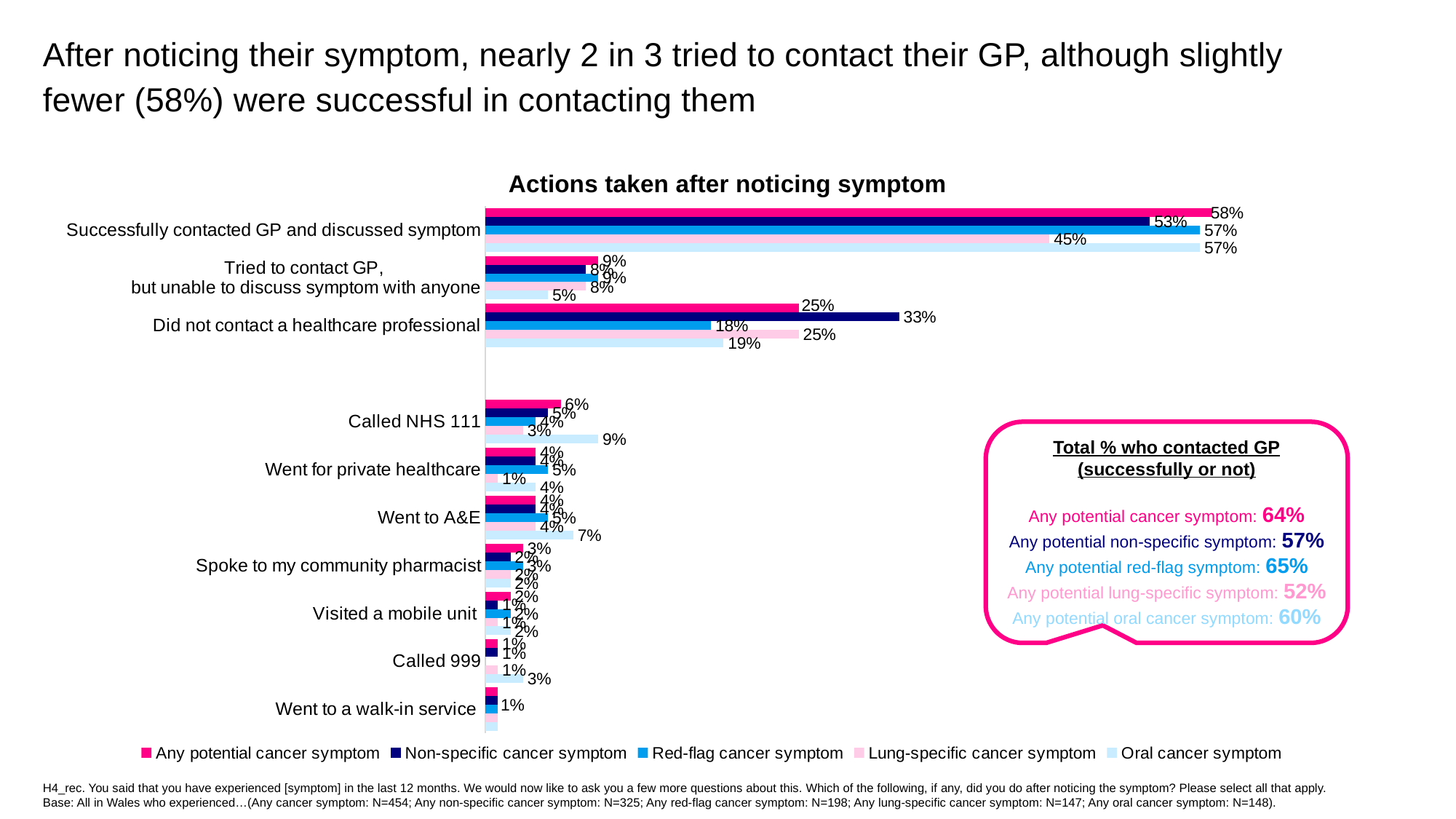
What kind of chart is shown on the slide? bar chart What is the title of the chart? Actions taken after noticing symptom What is the difference between the 'Non-specific cancer symptom' and 'Red-flag cancer symptom' values for 'Did not contact a healthcare professional'? 15% How many action categories are shown on the chart? 10 For 'Did not contact a healthcare professional', which is larger: the 'Any potential cancer symptom' value or the 'Red-flag cancer symptom' value? Any potential cancer symptom Which series has the lowest value for 'Successfully contacted GP and discussed symptom'? Lung-specific cancer symptom How many series does the legend list? 5 What is the value for 'Lung-specific cancer symptom' for 'Successfully contacted GP and discussed symptom'? 45% What is the value for 'Non-specific cancer symptom' for 'Did not contact a healthcare professional'? 33% What is the value for 'Oral cancer symptom' for 'Called NHS 111'? 9% What is the value for 'Any potential cancer symptom' for 'Successfully contacted GP and discussed symptom'? 58% Which series has the highest value for 'Did not contact a healthcare professional'? Non-specific cancer symptom